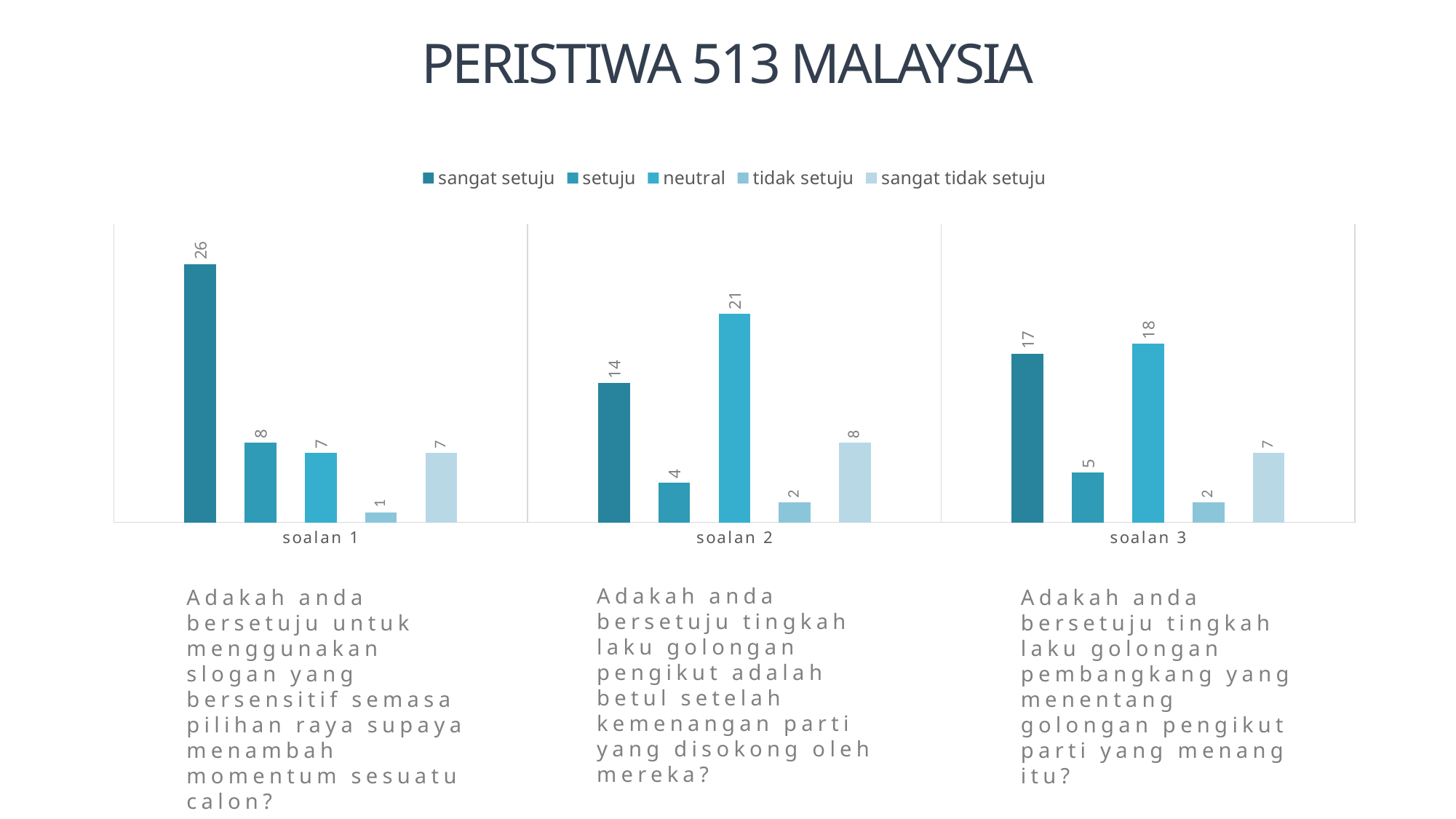
Which is larger in soalan 2: "sangat tidak setuju" or "setuju"? sangat tidak setuju How many series does the legend list? 5 What is the title of the slide containing the chart? PERISTIWA 513 MALAYSIA Which response series has the lowest value in soalan 1? tidak setuju What is the value for "neutral" in soalan 2? 21 What kind of chart is shown on the slide? bar chart What is the value for "tidak setuju" in soalan 3? 2 What is the difference between "sangat setuju" and "setuju" in soalan 1? 18 What is the value for "sangat setuju" in soalan 1? 26 Which response series has the highest value in soalan 3? neutral What is the difference between "neutral" and "sangat setuju" in soalan 2? 7 How many categories (soalan) are shown on the x axis? 3